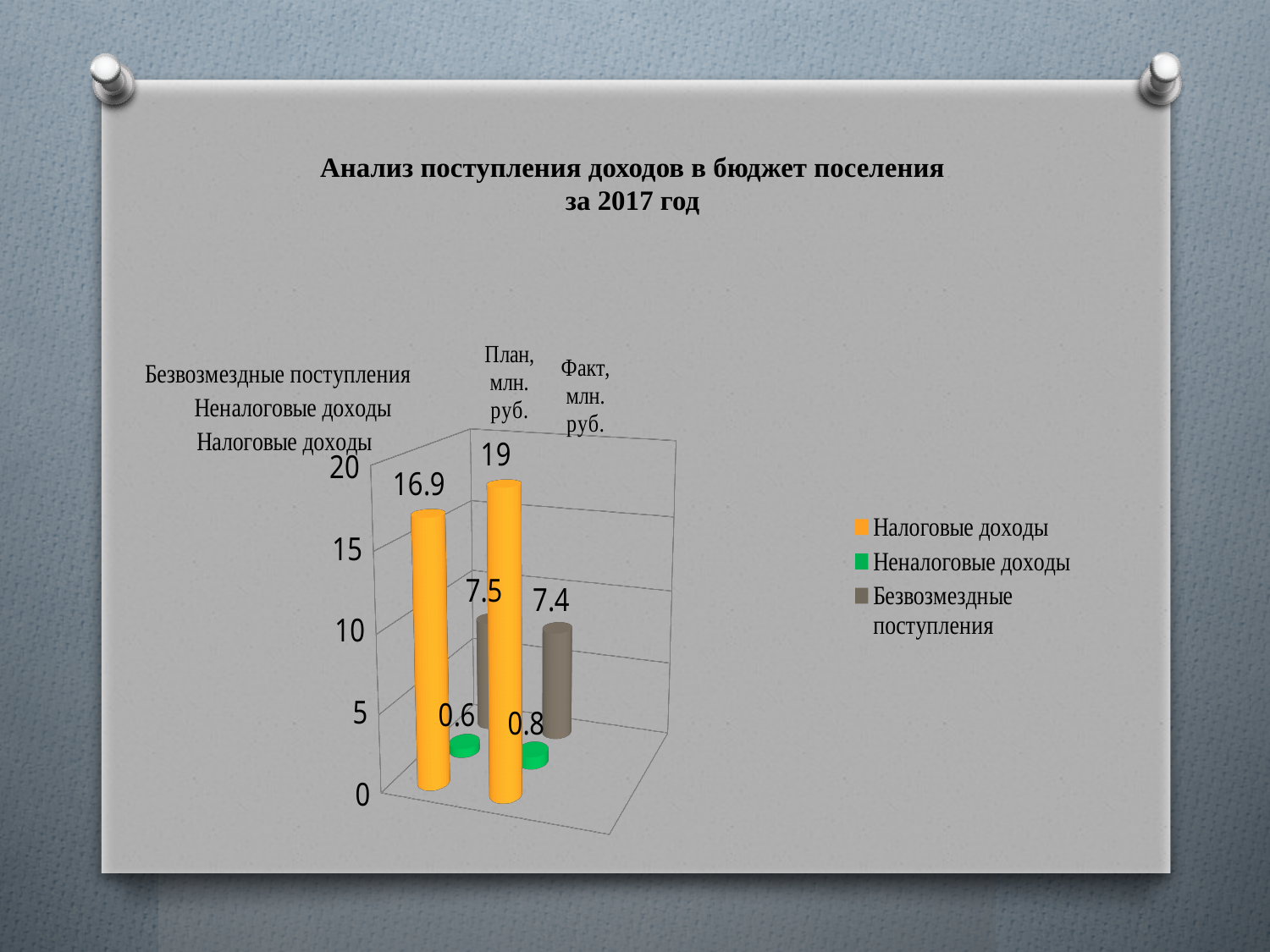
Is the Безвозмездные поступления value larger for План or for Факт? План Is the value of Налоговые доходы for Факт greater or less than 15? greater What is the value of Безвозмездные поступления for Факт, млн. руб.? 7.4 Which series has the lowest value for План, млн. руб.? Неналоговые доходы What is the value of Неналоговые доходы for План, млн. руб.? 0.6 What is the value of Налоговые доходы for Факт, млн. руб.? 19 What is the value of Налоговые доходы for План, млн. руб.? 16.9 How many series does the legend list? 3 What kind of chart is shown on the slide? Bar chart What colour represents Неналоговые доходы in the chart? Green Which series has the highest value for Факт, млн. руб.? Налоговые доходы What is the difference between the Факт and План values for Налоговые доходы? 2.1